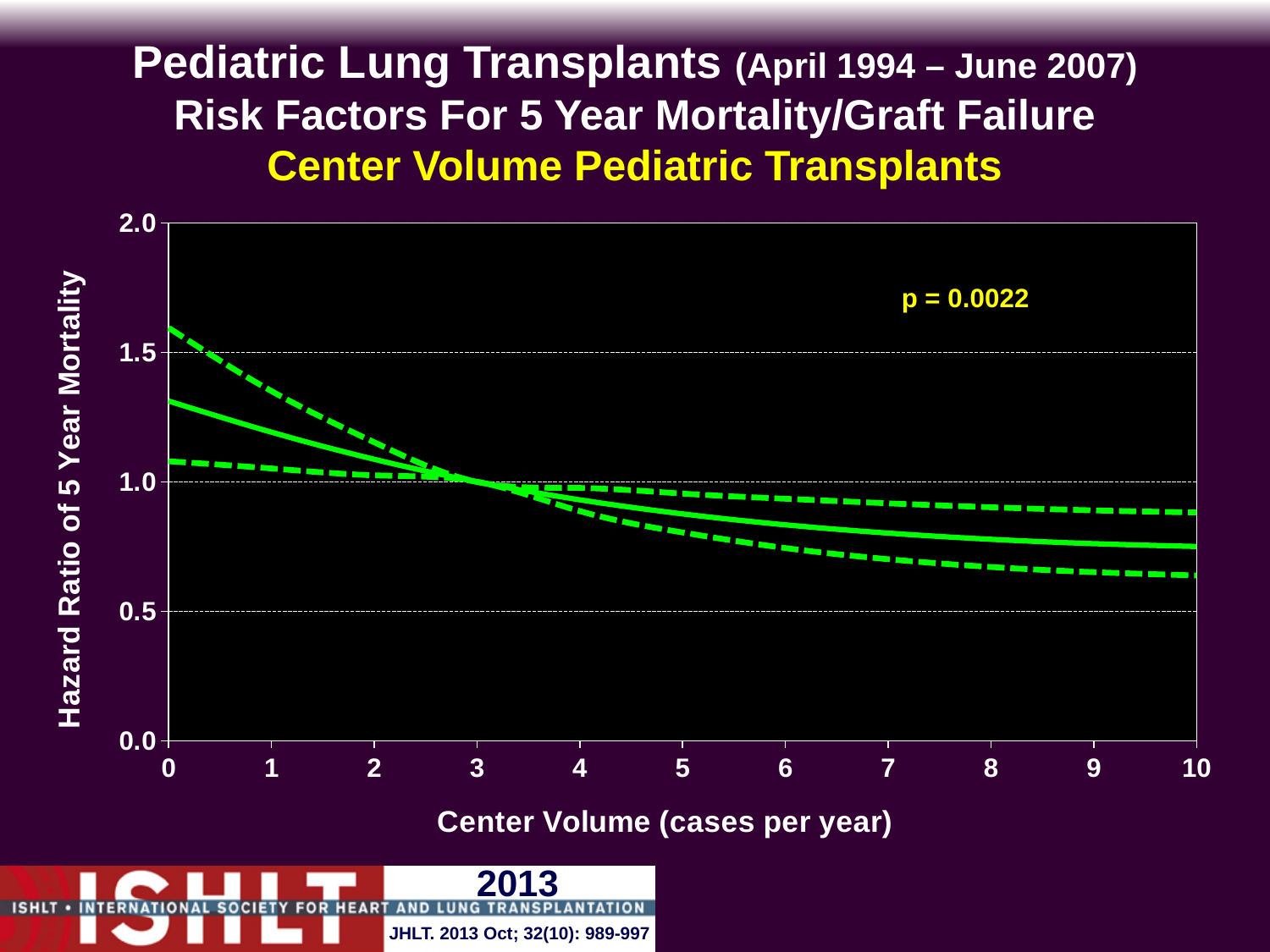
What p-value is printed on the chart? p = 0.0022 What is the highest value shown on the x axis (Center Volume)? 10 How many lines are plotted on the chart? 3 Is the hazard ratio on the solid line at a center volume of 10 cases per year greater or less than 1.0? less Is the upper dashed line at a center volume of 10 cases per year greater or less than 1.0? less What is the label of the y axis? Hazard Ratio of 5 Year Mortality What kind of chart is shown on the slide? line chart Is the lower dashed line at a center volume of 10 cases per year greater or less than 0.5? greater Is the solid line's hazard ratio higher at a center volume of 1 or at a center volume of 8 cases per year? 1 Does the solid hazard ratio line rise or fall as center volume increases from 0 to 10 cases per year? fall